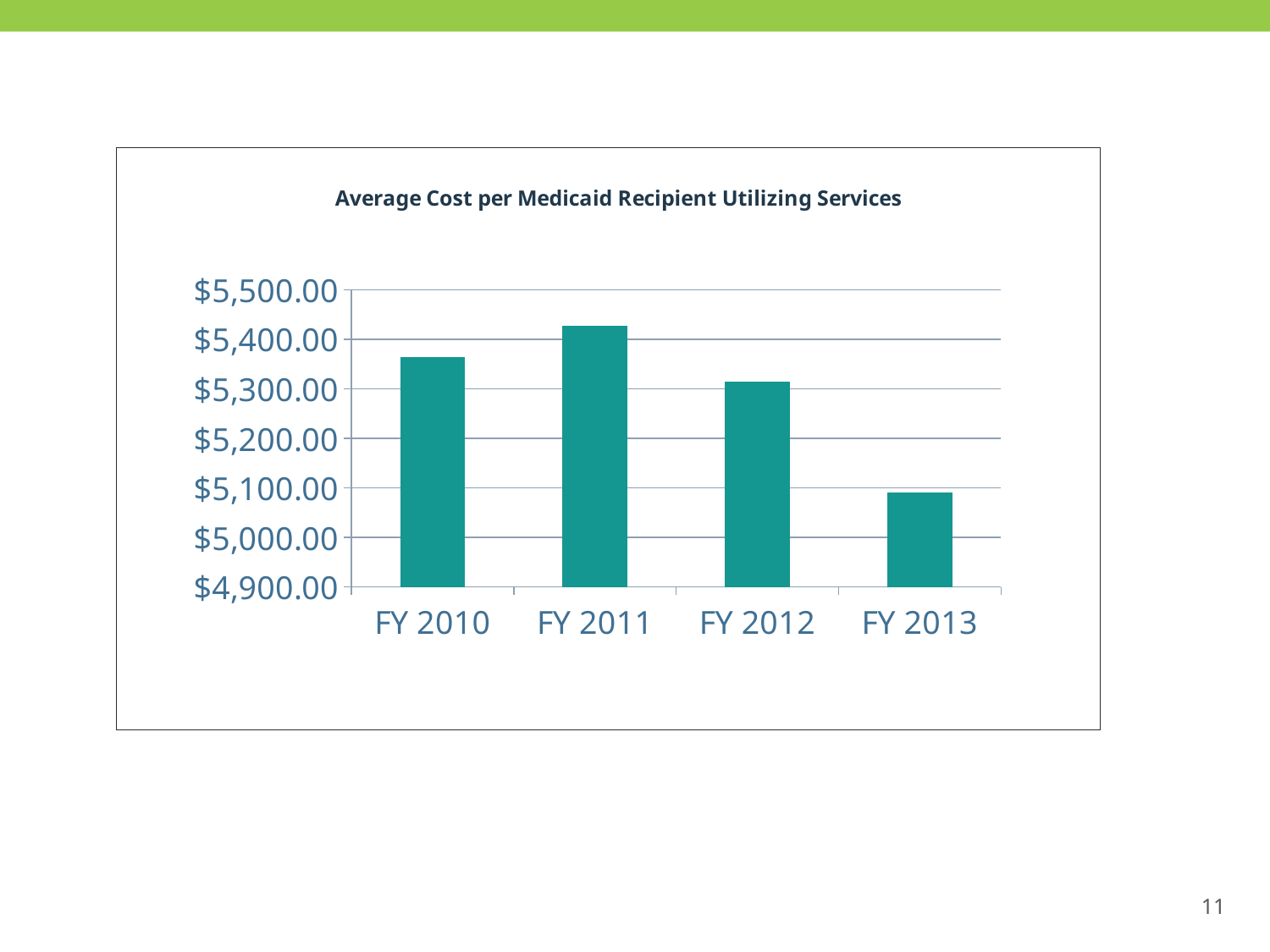
What colour are the bars in the chart? Teal What is the title of the chart? Average Cost per Medicaid Recipient Utilizing Services Is the value for FY 2013 greater or less than $5,200.00? less How many fiscal years are plotted on the chart? 4 Which is larger, the value for FY 2010 or the value for FY 2012? FY 2010 Is the value for FY 2012 greater or less than $5,400.00? less Is the value for FY 2011 greater or less than $5,400.00? greater What type of chart is shown on the slide? Bar chart Do the values rise or fall from FY 2011 to FY 2013? fall Which fiscal year has the highest average cost per Medicaid recipient? FY 2011 Which fiscal year has the lowest average cost per Medicaid recipient? FY 2013